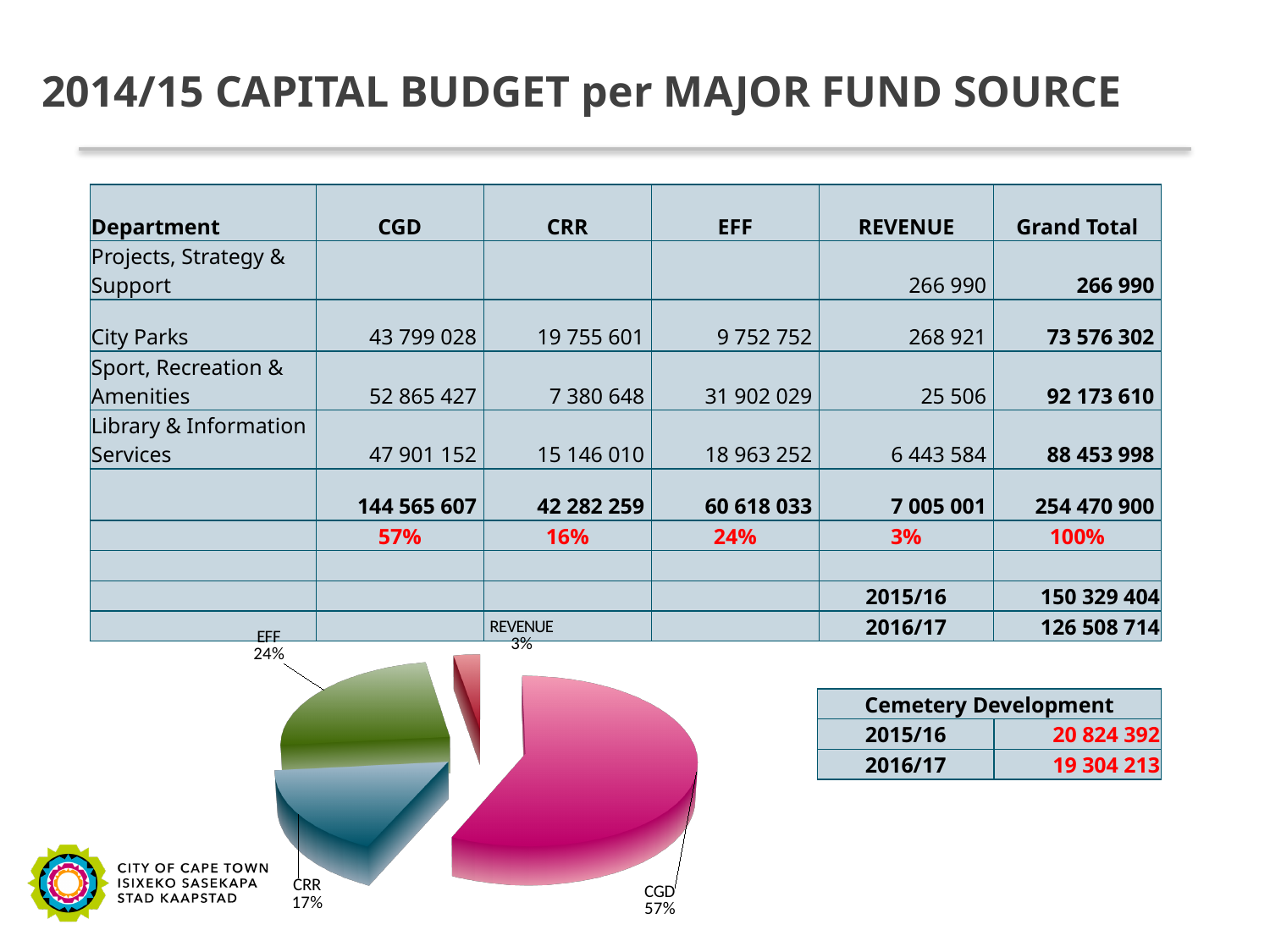
In the pie chart, which is larger, the EFF slice or the CRR slice? EFF What kind of chart is shown on the slide? Pie chart What share of the pie chart does CRR represent? 17% How many slices does the pie chart have? 4 What is the difference in percentage points between the CRR slice and the REVENUE slice in the pie chart? 14 What share of the pie chart does CGD represent? 57% Which fund source has the smallest slice in the pie chart? REVENUE What colour is the CGD slice in the pie chart? Pink What is the difference in percentage points between the CGD slice and the EFF slice in the pie chart? 33 What share of the pie chart does REVENUE represent? 3% Which fund source has the largest slice in the pie chart? CGD